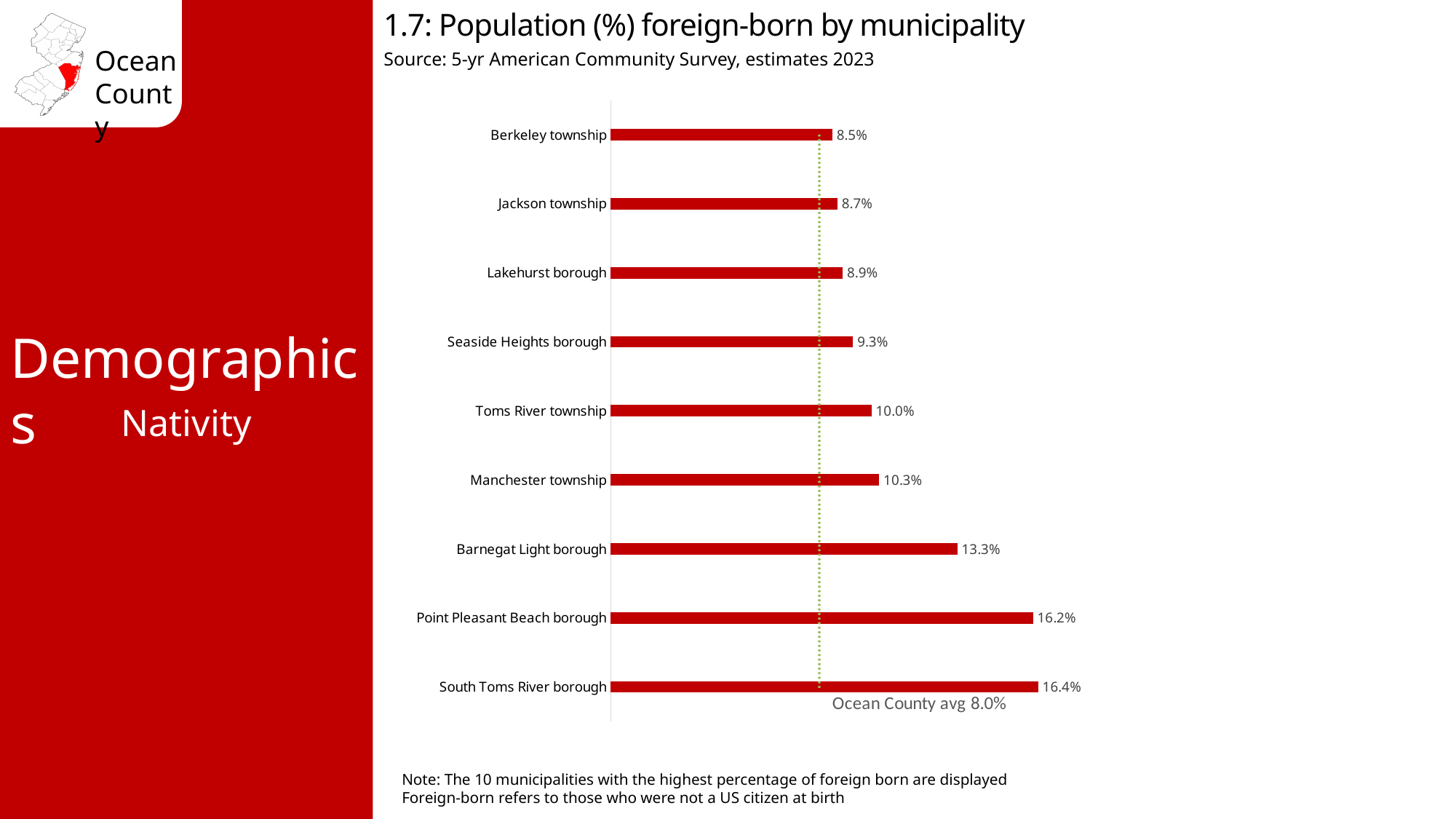
What is the foreign-born population percentage for Lakehurst borough? 8.9% What is the foreign-born population percentage for Barnegat Light borough? 13.3% What is the foreign-born population percentage for Toms River township? 10.0% How many municipalities are plotted in the chart? 9 Which has a higher foreign-born percentage, Seaside Heights borough or Jackson township? Seaside Heights borough What is the difference in foreign-born percentage between South Toms River borough and Berkeley township? 7.9% What is the difference in foreign-born percentage between Point Pleasant Beach borough and Manchester township? 5.9% What is the source of the data shown in the chart? 5-yr American Community Survey, estimates 2023 Which municipality has the highest foreign-born population percentage? South Toms River borough Which municipality has the lowest foreign-born population percentage shown? Berkeley township What is the Ocean County average foreign-born percentage marked by the dotted line? 8.0% What kind of chart is shown on the slide? Bar chart